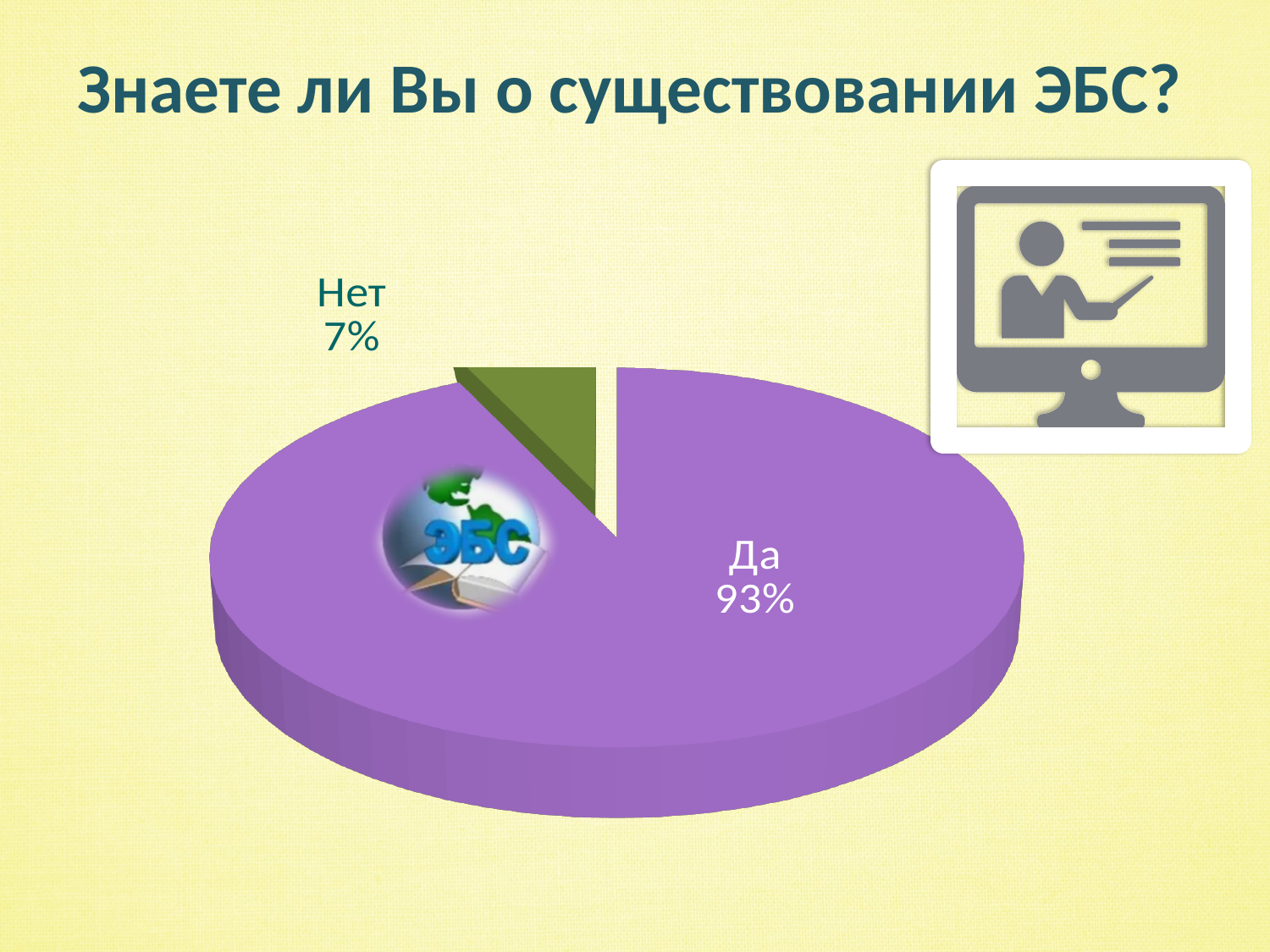
What share of the pie does the "Нет" slice represent? 7% What percentage of respondents answered "Да"? 93% Which slice of the pie is the smallest? Нет What is the title of the slide containing the pie chart? Знаете ли Вы о существовании ЭБС? Which is larger, the "Да" slice or the "Нет" slice? Да What kind of chart is shown on the slide? pie chart What is the difference in percentage points between the "Да" and "Нет" slices? 86 How many slices does the pie chart have? 2 Which slice of the pie is the largest? Да What percentage of respondents answered "Нет"? 7% What colour is the "Да" slice of the pie chart? purple